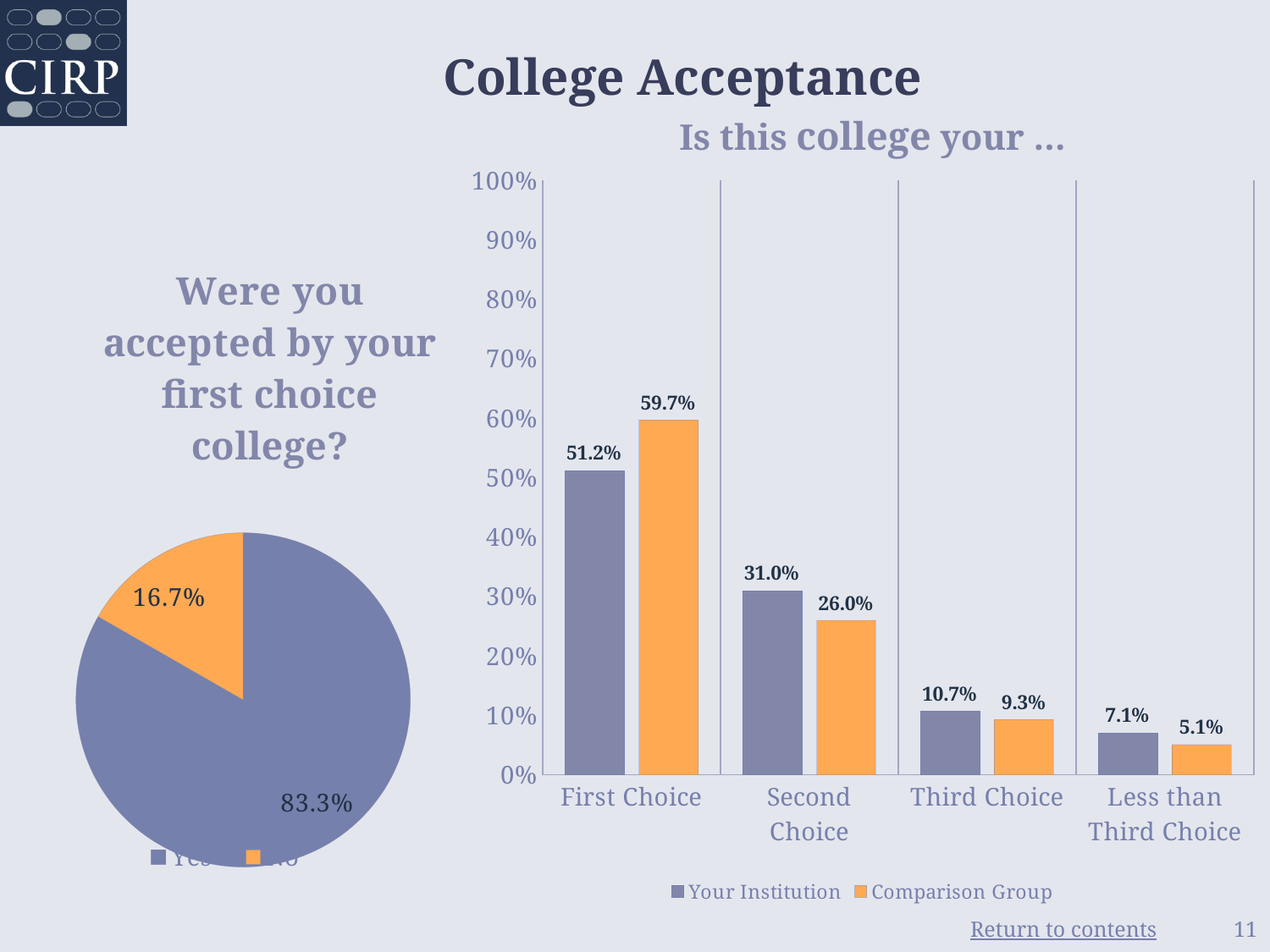
In the bar chart 'Is this college your ...', which category has the highest value for Your Institution? First Choice In the bar chart 'Is this college your ...', what is the difference between the Comparison Group and Your Institution values for First Choice? 8.5% In the bar chart 'Is this college your ...', which category has the lowest value for Comparison Group? Less than Third Choice In the bar chart 'Is this college your ...', what is the value for Your Institution for First Choice? 51.2% In the bar chart 'Is this college your ...', do the Your Institution values rise or fall from First Choice to Less than Third Choice? fall In the bar chart 'Is this college your ...', how many categories are shown on the x axis? 4 In the bar chart 'Is this college your ...', what is the value for Comparison Group for Second Choice? 26.0% In the bar chart 'Is this college your ...', what is the value for Comparison Group for Less than Third Choice? 5.1% In the bar chart 'Is this college your ...', how many series does the legend list? 2 What kind of chart is the chart on the left of the slide, under 'Were you accepted by your first choice college?'? pie chart In the bar chart 'Is this college your ...', which is larger for Third Choice: Your Institution or Comparison Group? Your Institution In the pie chart on the left of the slide, what is the share of the largest slice? 83.3%